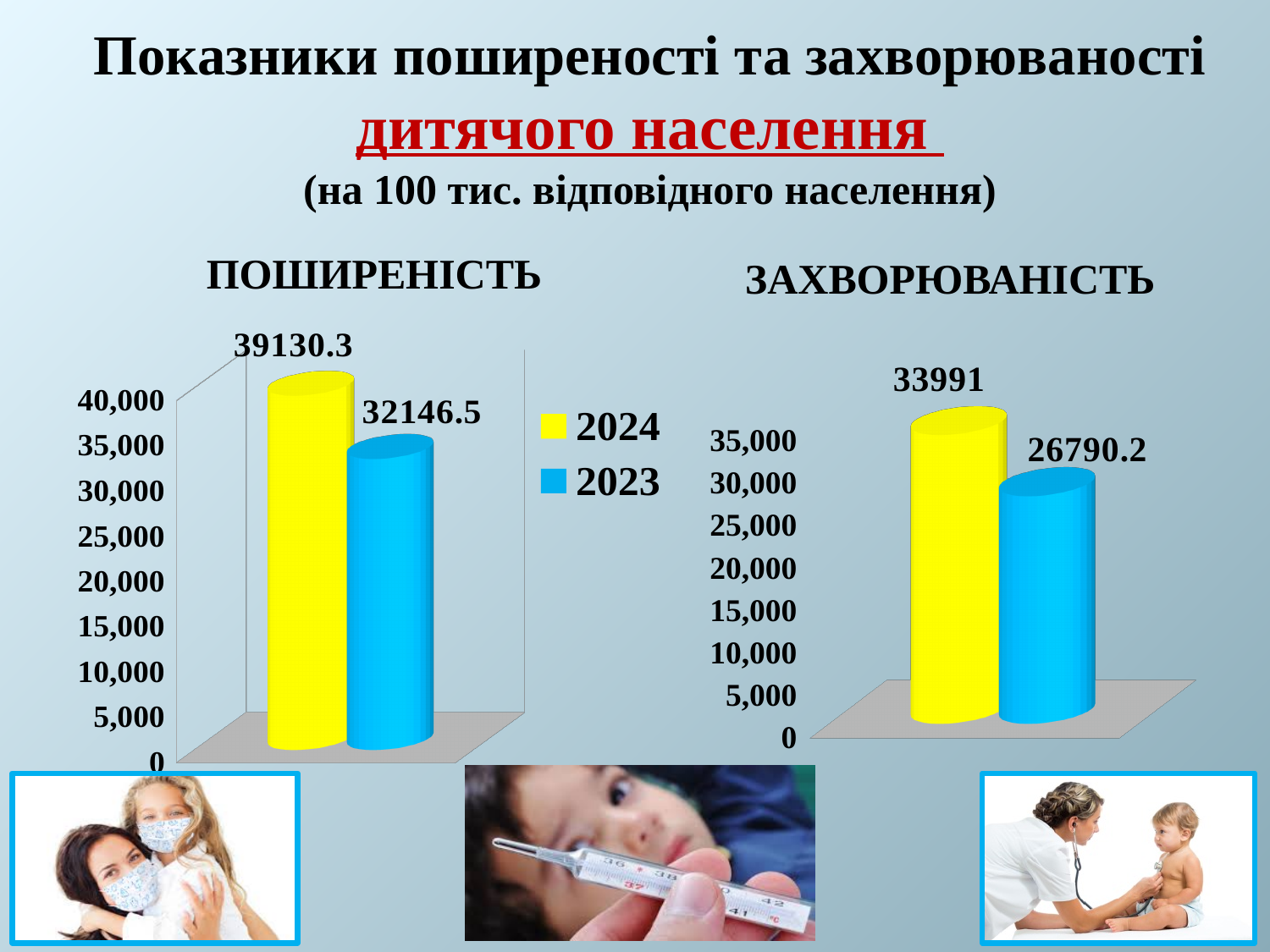
In the ЗАХВОРЮВАНІСТЬ chart, which year has the lower value? 2023 In the ПОШИРЕНІСТЬ chart, what is the value for 2023? 32146.5 In the ЗАХВОРЮВАНІСТЬ chart, what is the value for 2024? 33991 In the ЗАХВОРЮВАНІСТЬ chart, is the value for 2023 greater or less than 30,000? less In the ПОШИРЕНІСТЬ chart, which year has the higher value? 2024 In the ЗАХВОРЮВАНІСТЬ chart, what is the value for 2023? 26790.2 In the ЗАХВОРЮВАНІСТЬ chart, what is the difference between the 2024 and 2023 values? 7200.8 How many series does the legend list? 2 In the ПОШИРЕНІСТЬ chart, what is the value for 2024? 39130.3 In the ПОШИРЕНІСТЬ chart, what is the difference between the 2024 and 2023 values? 6983.8 What type of chart is the ПОШИРЕНІСТЬ chart? bar chart Is the 2024 value in the ЗАХВОРЮВАНІСТЬ chart larger or smaller than the 2023 value in the ПОШИРЕНІСТЬ chart? larger